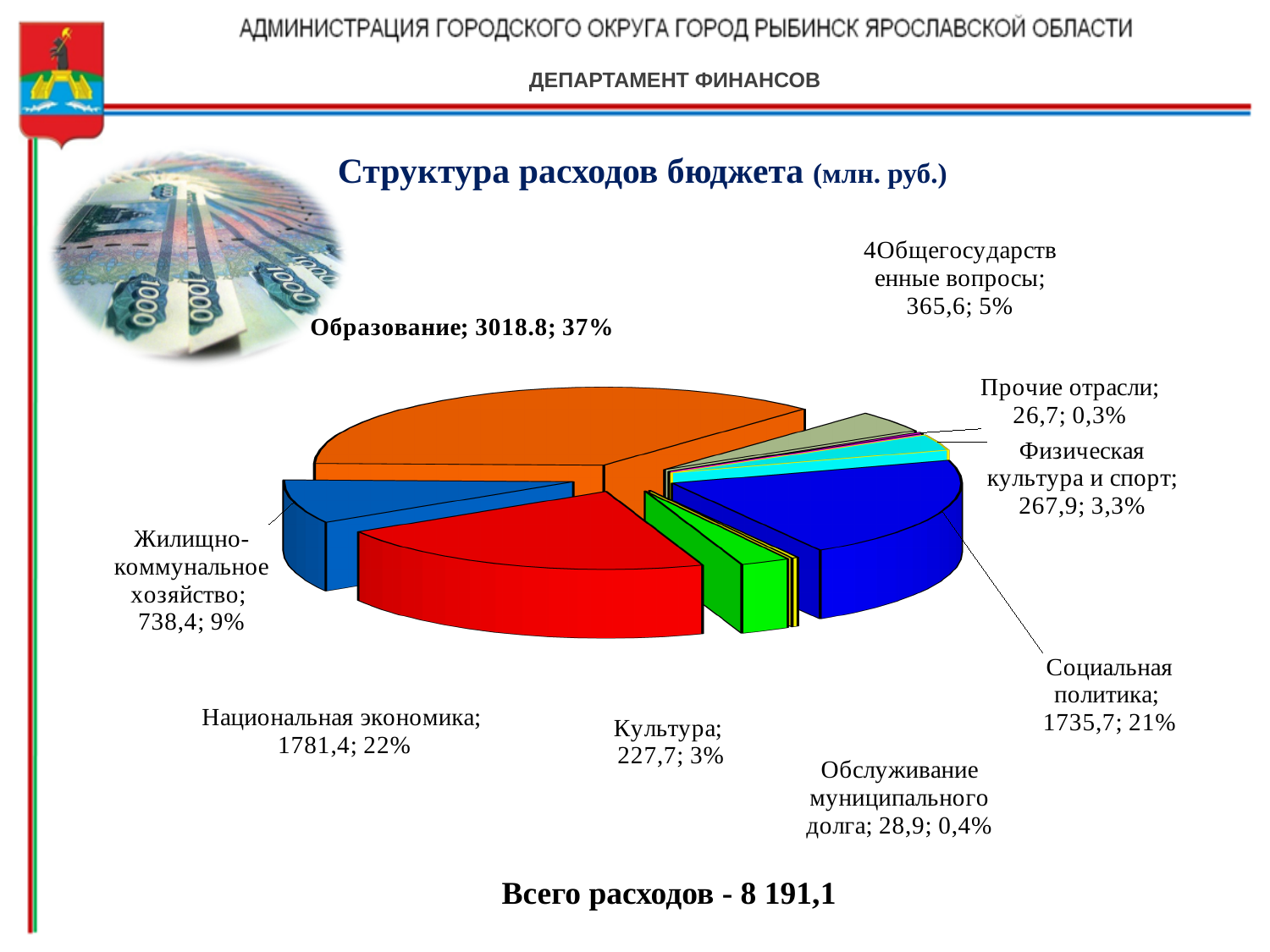
How many categories are shown in the pie chart? 9 Which category has the largest share of the pie? Образование What is the difference between the values for Национальная экономика and Социальная политика? 45,7 What is the value for Жилищно-коммунальное хозяйство? 738,4 What share of the pie does Социальная политика take? 21% What share of the pie does Физическая культура и спорт take? 3,3% What is the value for Образование? 3018.8 Which is larger, Национальная экономика or Социальная политика? Национальная экономика What is the title of the chart? Структура расходов бюджета (млн. руб.) Which category has the smallest share of the pie? Прочие отрасли What kind of chart is shown on the slide? Pie chart What is the value for Национальная экономика? 1781,4